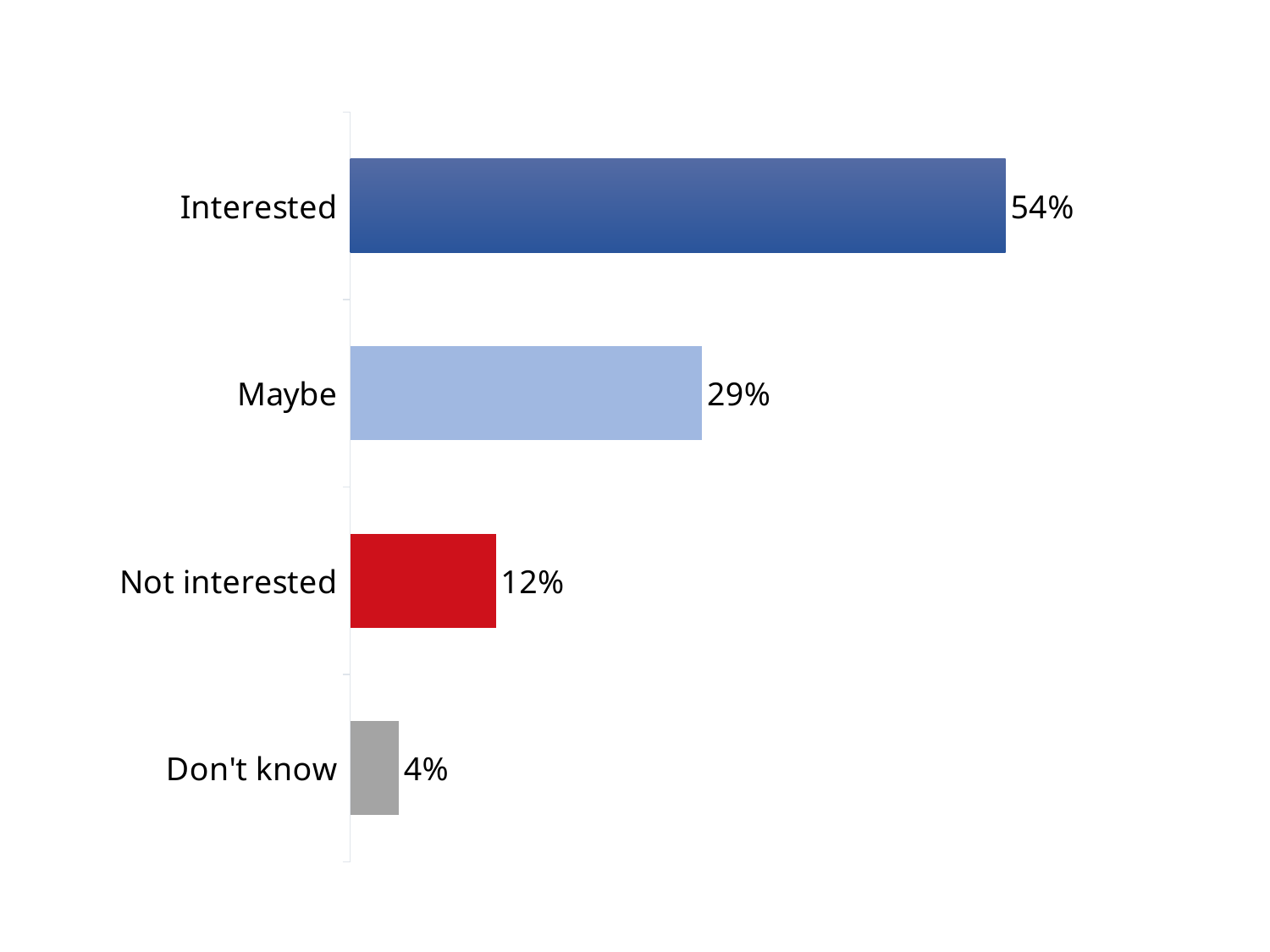
Which is larger, the value for Maybe or the value for Not interested? Maybe What is the difference between the values for Not interested and Don't know? 8% What kind of chart is shown on the slide? Bar chart What is the difference between the values for Interested and Maybe? 25% What is the value for Not interested? 12% How many categories are shown in the chart? 4 Which category has the lowest value? Don't know What is the value for Interested? 54% What is the value for Maybe? 29% What colour is the bar for Not interested? Red What is the value for Don't know? 4% Which category has the highest value? Interested